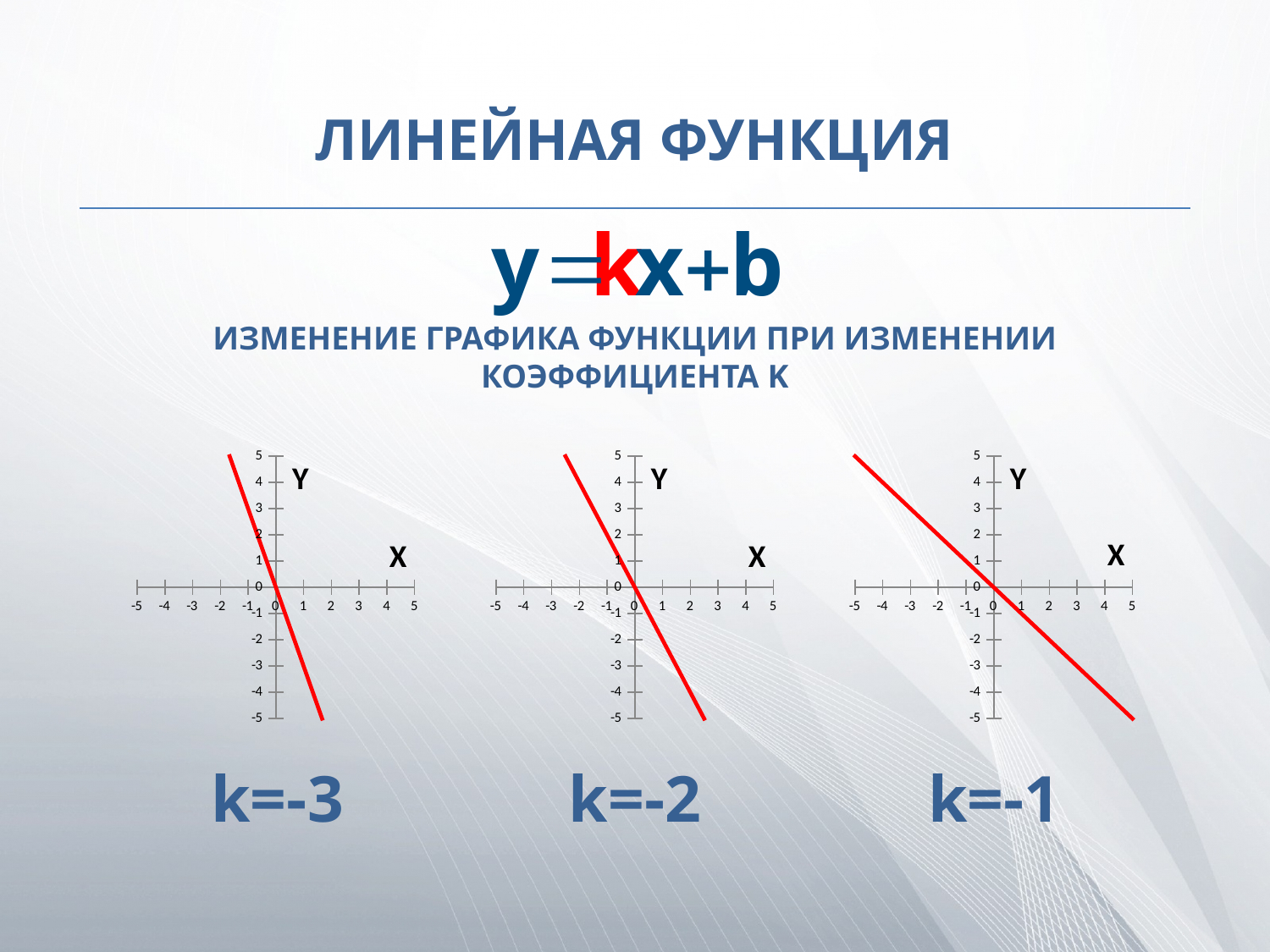
What value of k is written under the middle chart? k=-2 What is the highest value shown on the x axis of the chart labelled k=-2? 5 In the chart labelled k=-2, is the value of y at x=-1 greater or less than 0? greater What kind of chart is shown in the left chart labelled k=-3? line chart In the chart labelled k=-1, do the values of y rise or fall as x increases? fall What is the lowest value shown on the y axis of the chart labelled k=-1? -5 In the chart labelled k=-3, is the value of y at x=1 greater or less than 0? less How many charts are shown on the slide? 3 In the chart labelled k=-3, what is the value of y at x=0? 0 In the chart labelled k=-2, do the values of y rise or fall as x increases? fall Which of the three charts shows the steepest line? k=-3 In the chart labelled k=-1, is the value of y at x=-2 greater or less than 0? greater